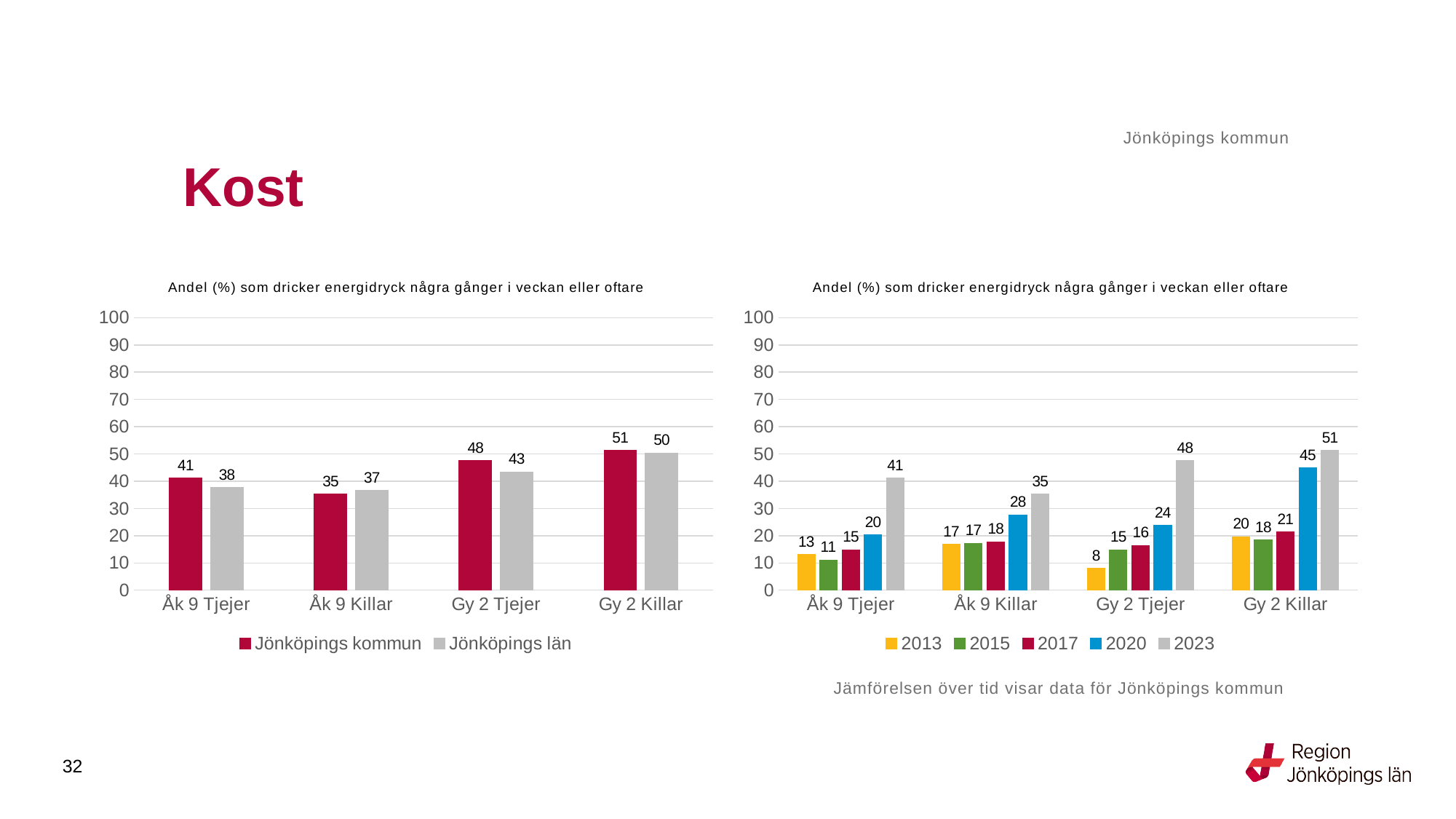
In the left chart, what is the value for Jönköpings län for Åk 9 Killar? 37 In the right chart, what is the difference between the 2023 and 2020 values for Åk 9 Tjejer? 21 In the right chart, what is the value for 2020 for Gy 2 Killar? 45 In the left chart, which category has the highest value for Jönköpings kommun? Gy 2 Killar In the left chart, what is the value for Jönköpings kommun for Gy 2 Tjejer? 48 In the right chart, how many series does the legend list? 5 In the right chart, which category has the lowest value for 2023? Åk 9 Killar In the right chart, which is larger for Åk 9 Killar: the 2020 value or the 2017 value? 2020 In the left chart, how many series does the legend list? 2 In the left chart, what is the difference between Jönköpings kommun and Jönköpings län for Gy 2 Tjejer? 5 What kind of chart is the right chart? Bar chart In the right chart, what is the value for 2013 for Gy 2 Tjejer? 8